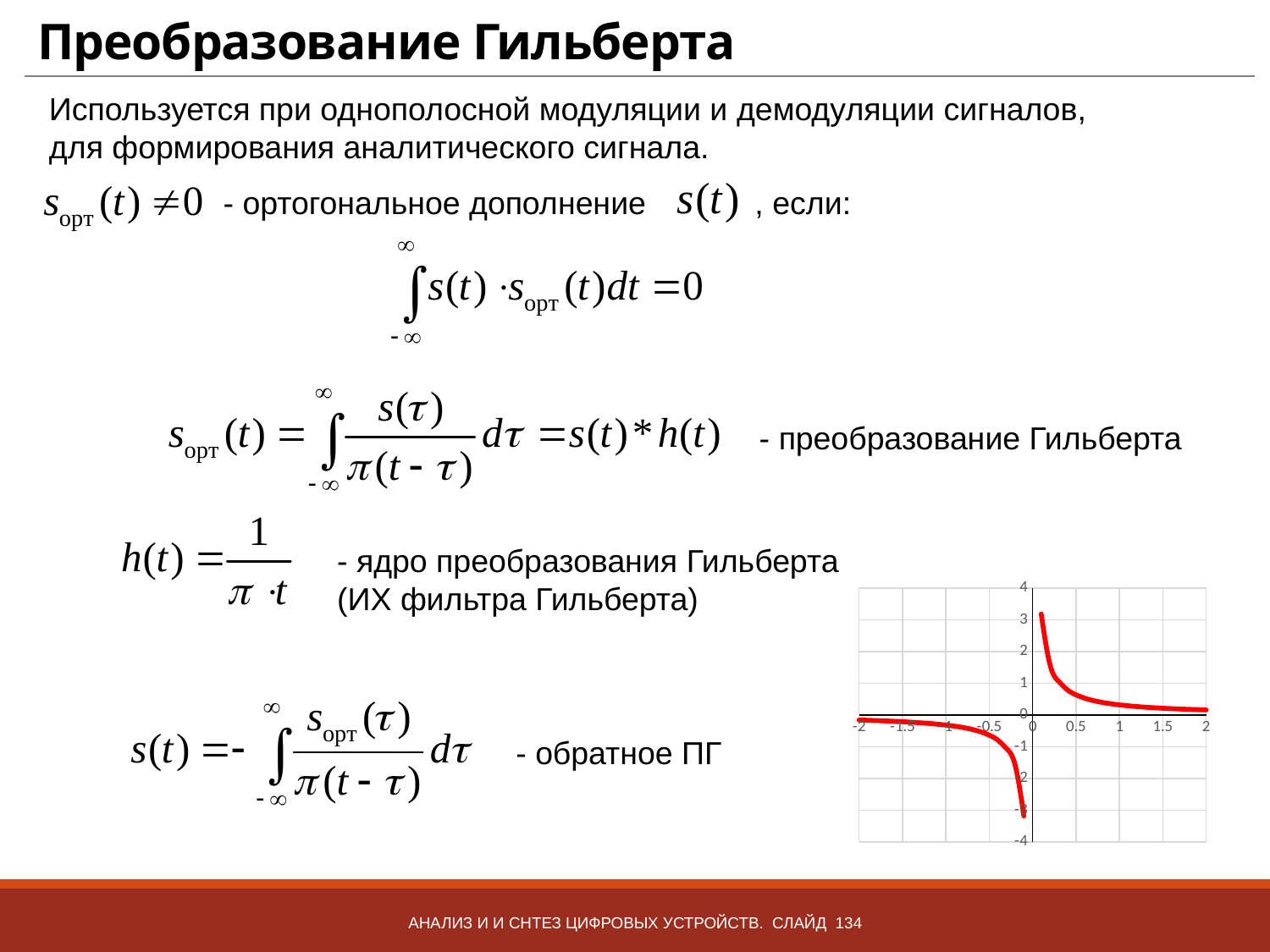
What kind of chart is shown at the bottom right of the slide? line chart What colour is the curve plotted in the chart at the bottom right of the slide? red In the chart at the bottom right, is the value of the curve at x = -0.5 greater or less than -1? greater In the chart at the bottom right, do the values of the curve rise or fall as x increases from 0.5 to 2? fall In the chart at the bottom right, is the value of the curve at x = -1 greater or less than -1? greater In the chart at the bottom right, is the value of the curve at x = 1 greater or less than 1? less In the chart at the bottom right, do the values of the curve rise or fall as x increases from -2 towards 0? fall What is the range of the x axis in the chart at the bottom right of the slide? -2 to 2 In the chart at the bottom right, which is larger: the value of the curve at x = 0.5 or at x = 1.5? x = 0.5 In the chart at the bottom right, which is larger: the value of the curve at x = -0.5 or at x = 0.5? x = 0.5